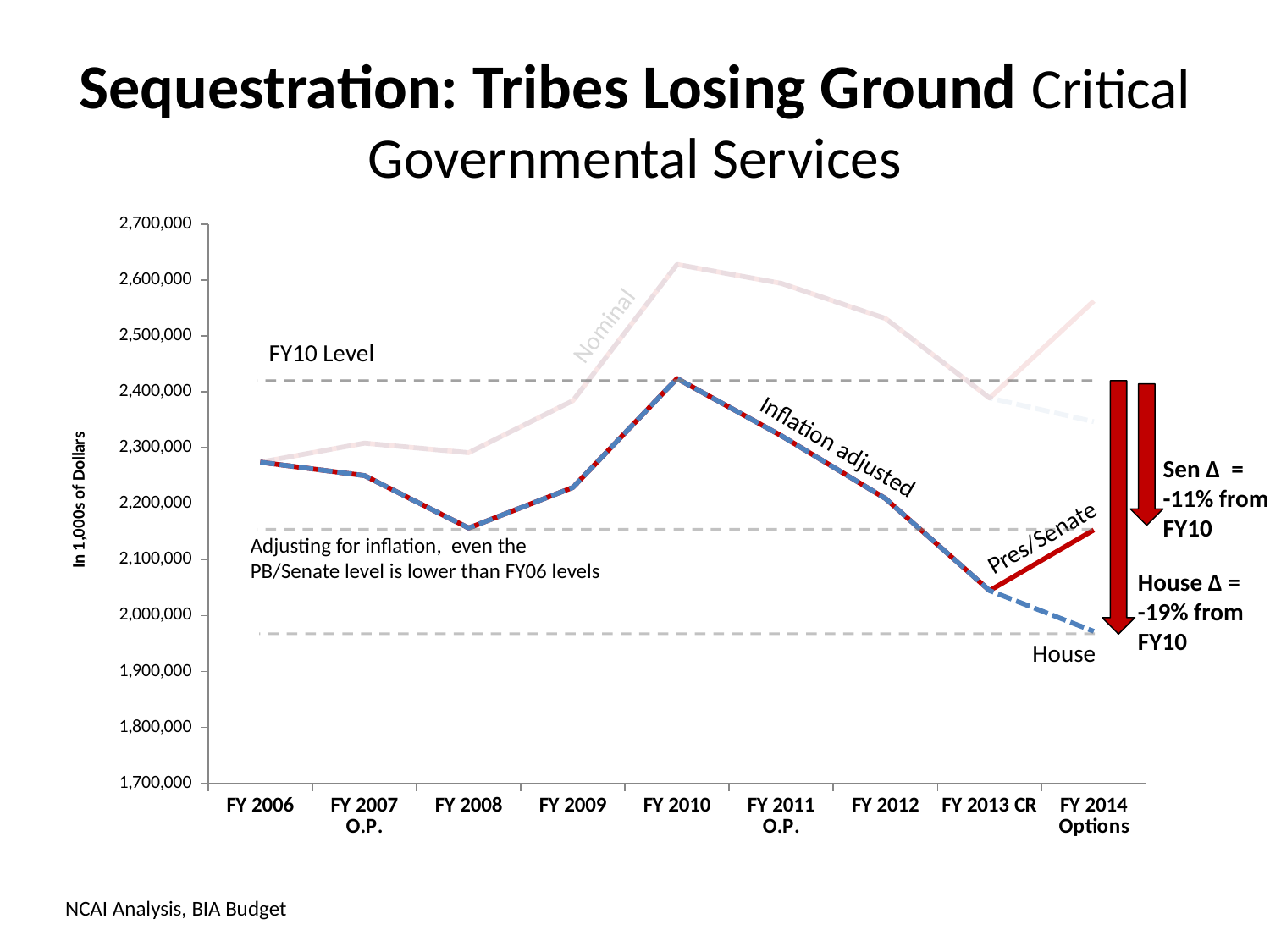
Is the Inflation adjusted value for FY 2013 CR greater or less than 2,100,000? less On the Inflation adjusted line, which is larger: the value for FY 2006 or the value for FY 2008? FY 2006 What kind of chart is shown on the slide? line chart Is the Inflation adjusted value for FY 2008 greater or less than 2,200,000? less Is the Nominal value for FY 2010 greater or less than 2,600,000? greater According to the annotation on the slide, what is the Senate change from FY10? -11% from FY10 Does the Inflation adjusted line rise or fall from FY 2010 to FY 2013 CR? fall How many fiscal year categories are shown on the x axis? 9 Which fiscal year has the highest value on the Inflation adjusted line? FY 2010 Which fiscal year has the lowest value on the Inflation adjusted line? FY 2013 CR